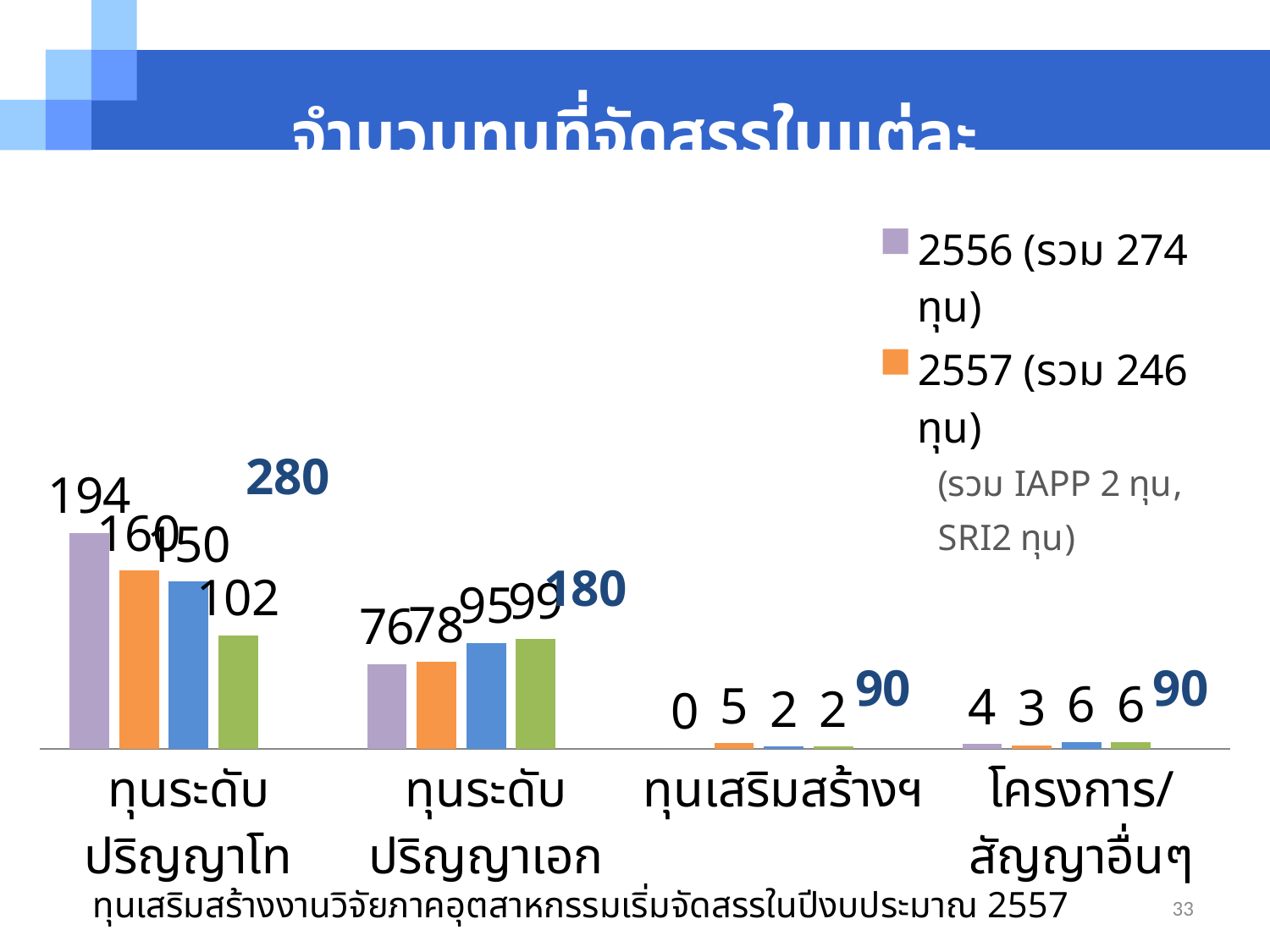
What is the value for 2557 in the โครงการ/สัญญาอื่นๆ category? 3 What is the value for 2557 in the ทุนระดับปริญญาโท category? 160 What is the value for 2557 in the ทุนระดับปริญญาเอก category? 78 What kind of chart is shown on the slide? bar chart For ทุนระดับปริญญาเอก, which series has the larger value, 2556 or 2557? 2557 What is the value for 2556 in the ทุนระดับปริญญาโท category? 194 What is the value for 2556 in the ทุนระดับปริญญาเอก category? 76 What is the value for 2556 in the ทุนเสริมสร้างฯ category? 0 Which category has the highest value for the 2556 series? ทุนระดับปริญญาโท According to the legend, what is the total number of grants (รวม) for 2556? 274 ทุน What is the difference between the 2556 and 2557 values for ทุนระดับปริญญาโท? 34 How many categories are shown on the x axis of the chart? 4